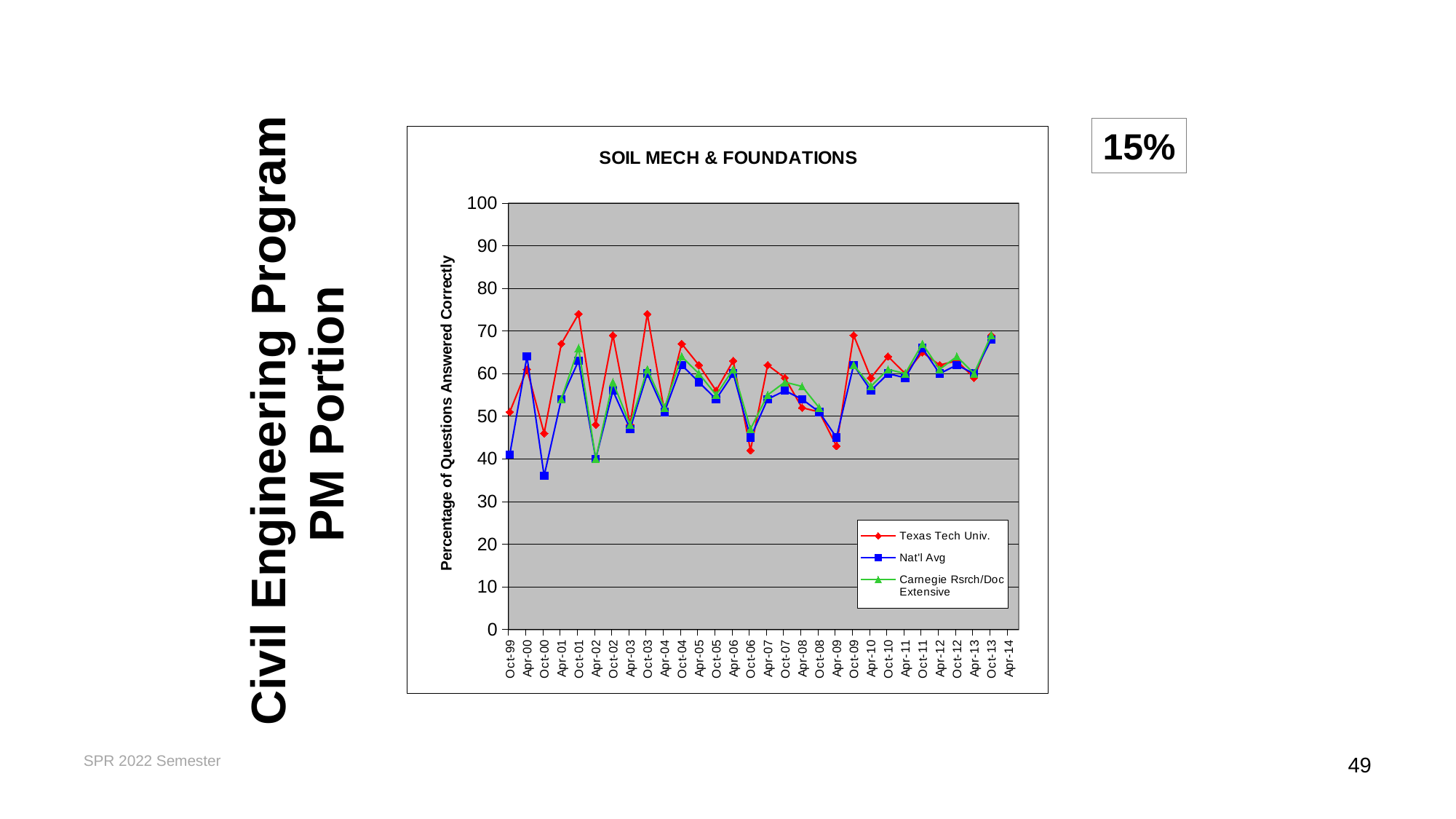
Is the value for Nat'l Avg at Oct-00 greater or less than 40? less At Oct-00, which is larger: Texas Tech Univ. or Nat'l Avg? Texas Tech Univ. At Oct-01, which is larger: Texas Tech Univ. or Nat'l Avg? Texas Tech Univ. At which date is the Nat'l Avg series at its lowest? Oct-00 Is the value for Texas Tech Univ. at Oct-06 greater or less than 50? less What kind of chart is shown on the slide? Line chart What is the title of the chart? SOIL MECH & FOUNDATIONS Is the value for Texas Tech Univ. at Oct-01 greater or less than 70? greater What is the label on the vertical axis of the chart? Percentage of Questions Answered Correctly How many series does the legend list? 3